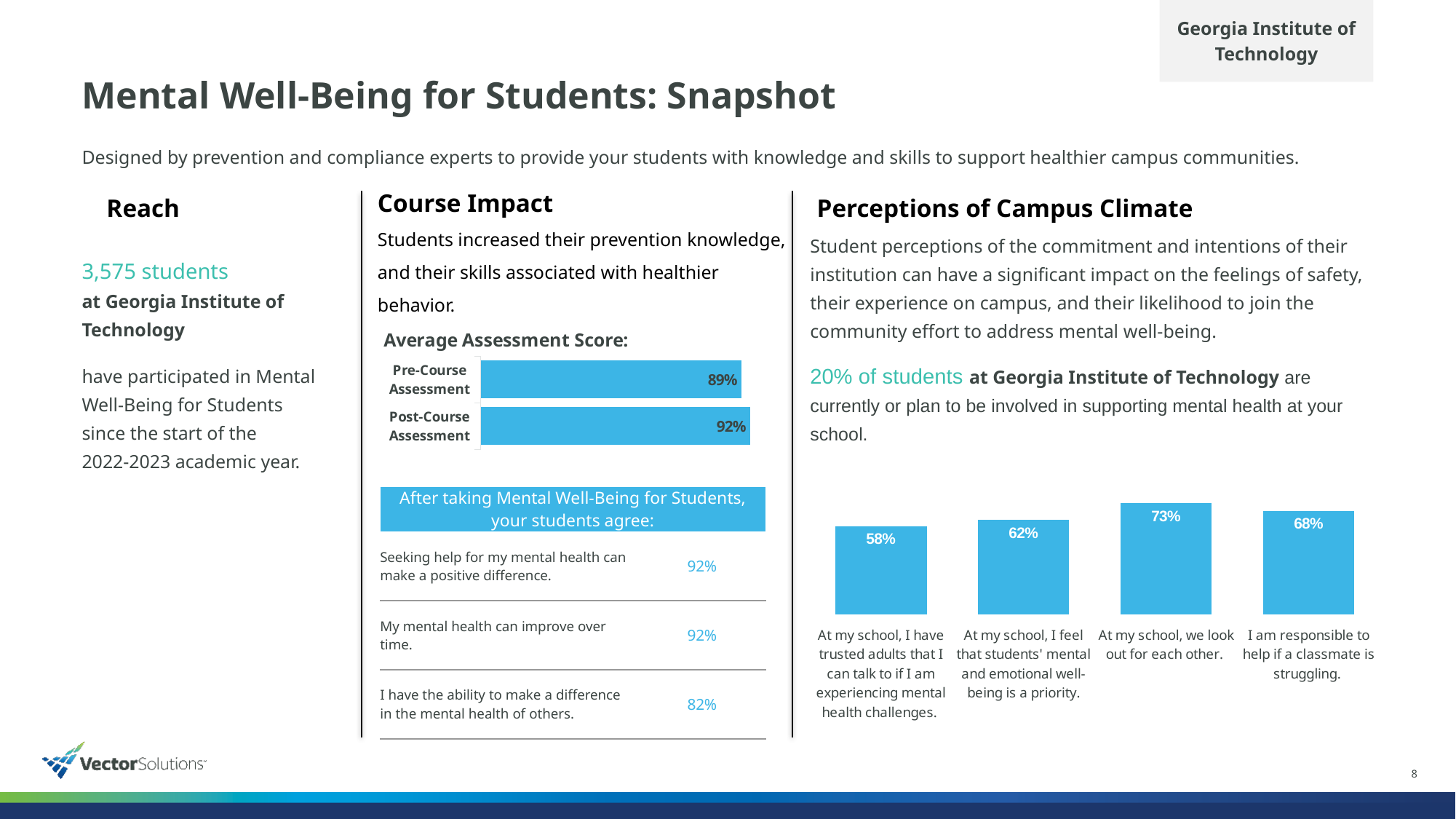
In the Perceptions of Campus Climate chart, what percentage of students agree that 'At my school, I have trusted adults that I can talk to if I am experiencing mental health challenges'? 58% In the Average Assessment Score chart, what is the value for the Post-Course Assessment? 92% In the Average Assessment Score chart, how many bars are shown? 2 In the Average Assessment Score chart, what is the difference between the Post-Course and Pre-Course Assessment scores? 3% What kind of chart is the Average Assessment Score chart? Bar chart In the Perceptions of Campus Climate chart, how many bars are shown? 4 In the Perceptions of Campus Climate chart, what is the difference between the percentage for 'I am responsible to help if a classmate is struggling' and 'At my school, I feel that students' mental and emotional well-being is a priority'? 6% In the Perceptions of Campus Climate chart, which statement has the highest percentage? At my school, we look out for each other. In the Average Assessment Score chart, what is the value for the Pre-Course Assessment? 89% In the Perceptions of Campus Climate chart, which statement has the lowest percentage? At my school, I have trusted adults that I can talk to if I am experiencing mental health challenges. In the Perceptions of Campus Climate chart, what percentage of students agree that 'At my school, we look out for each other'? 73% In the Average Assessment Score chart, which assessment has the higher score, Pre-Course or Post-Course? Post-Course Assessment